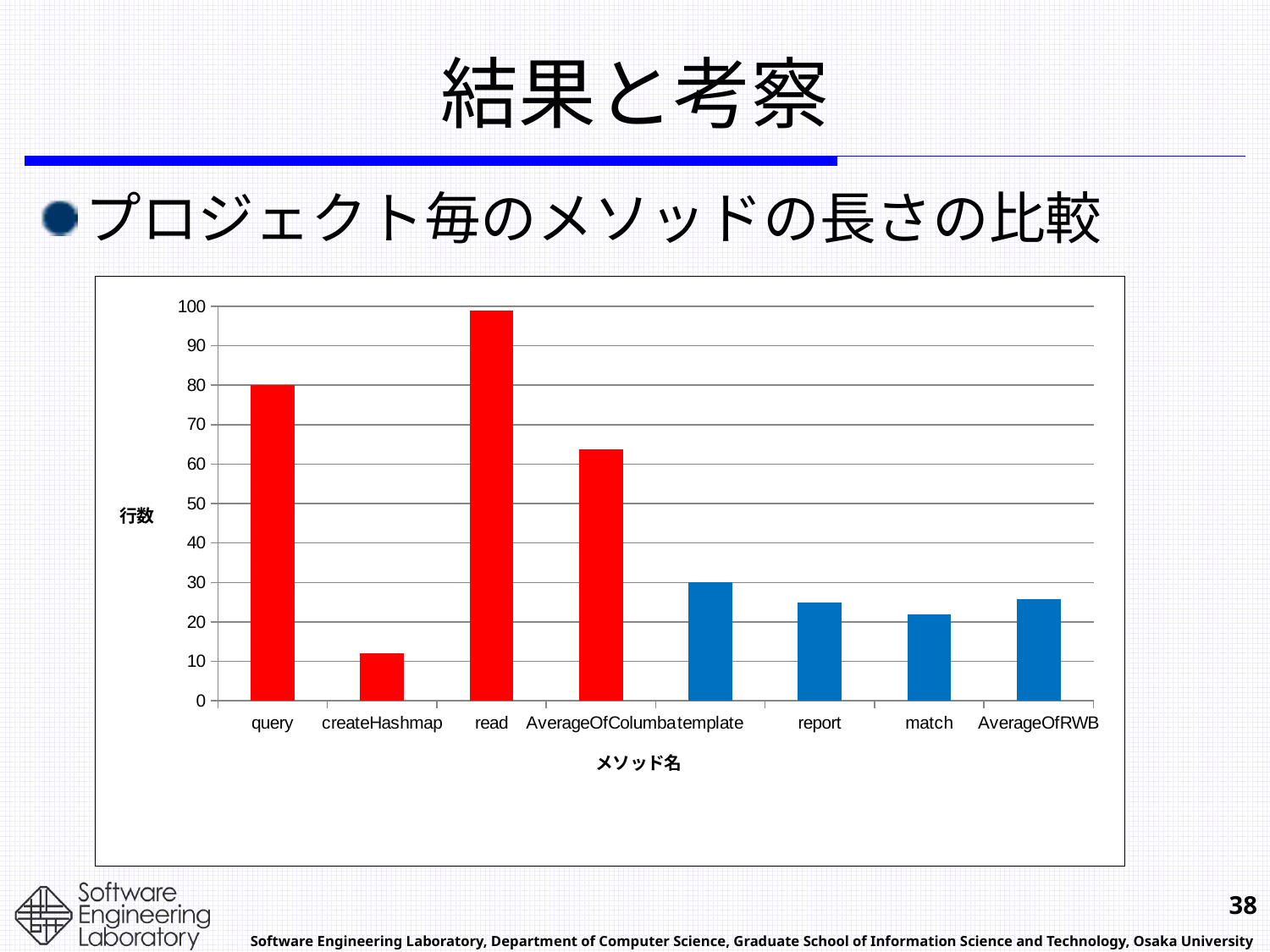
What is the label of the horizontal axis? メソッド名 Is the value for AverageOfColumba greater or less than 60? greater Which is larger, the value for query or the value for AverageOfColumba? query Which is larger, the value for template or the value for match? template Which method has the highest value (行数)? read What is the label of the vertical axis? 行数 Is the value for match greater or less than 30? less How many methods (categories) are plotted on the x axis? 8 Is the value for read greater or less than 90? greater Which method has the lowest value (行数)? createHashmap What kind of chart is shown on the slide? bar chart